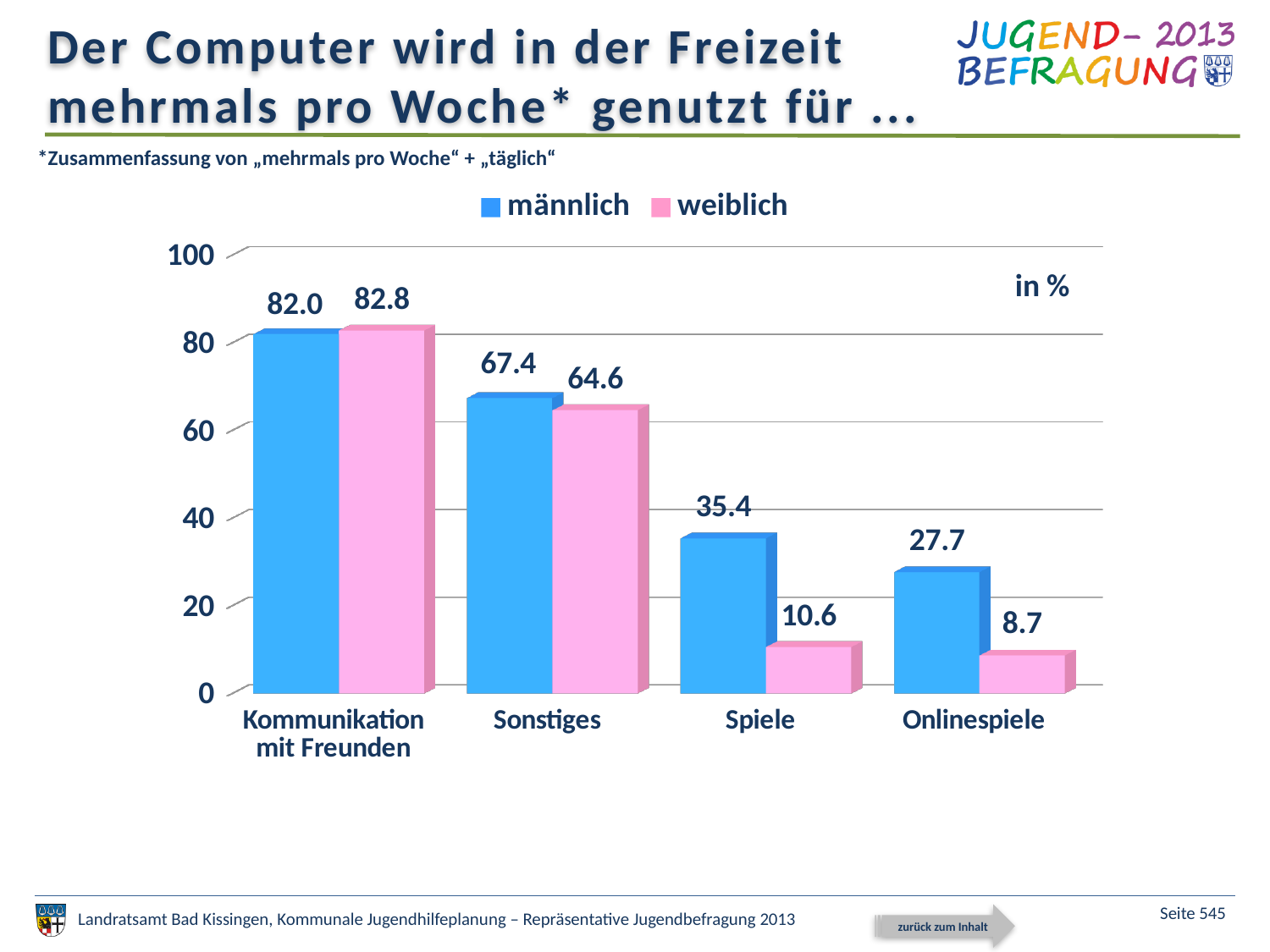
What is the value for weiblich in the Spiele category? 10.6 Which category has the lowest value for weiblich? Onlinespiele Is the value for männlich in the Onlinespiele category greater or less than 20? greater What is the difference between the männlich and weiblich values in the Spiele category? 24.8 Which category has the highest value for männlich? Kommunikation mit Freunden How many series does the legend list? 2 What is the value for weiblich in the Onlinespiele category? 8.7 Which is larger in the Sonstiges category, the männlich value or the weiblich value? männlich What unit is indicated for the values in the chart? in % What is the value for männlich in the Kommunikation mit Freunden category? 82.0 What kind of chart is shown on the slide? bar chart How many categories are shown on the x axis? 4